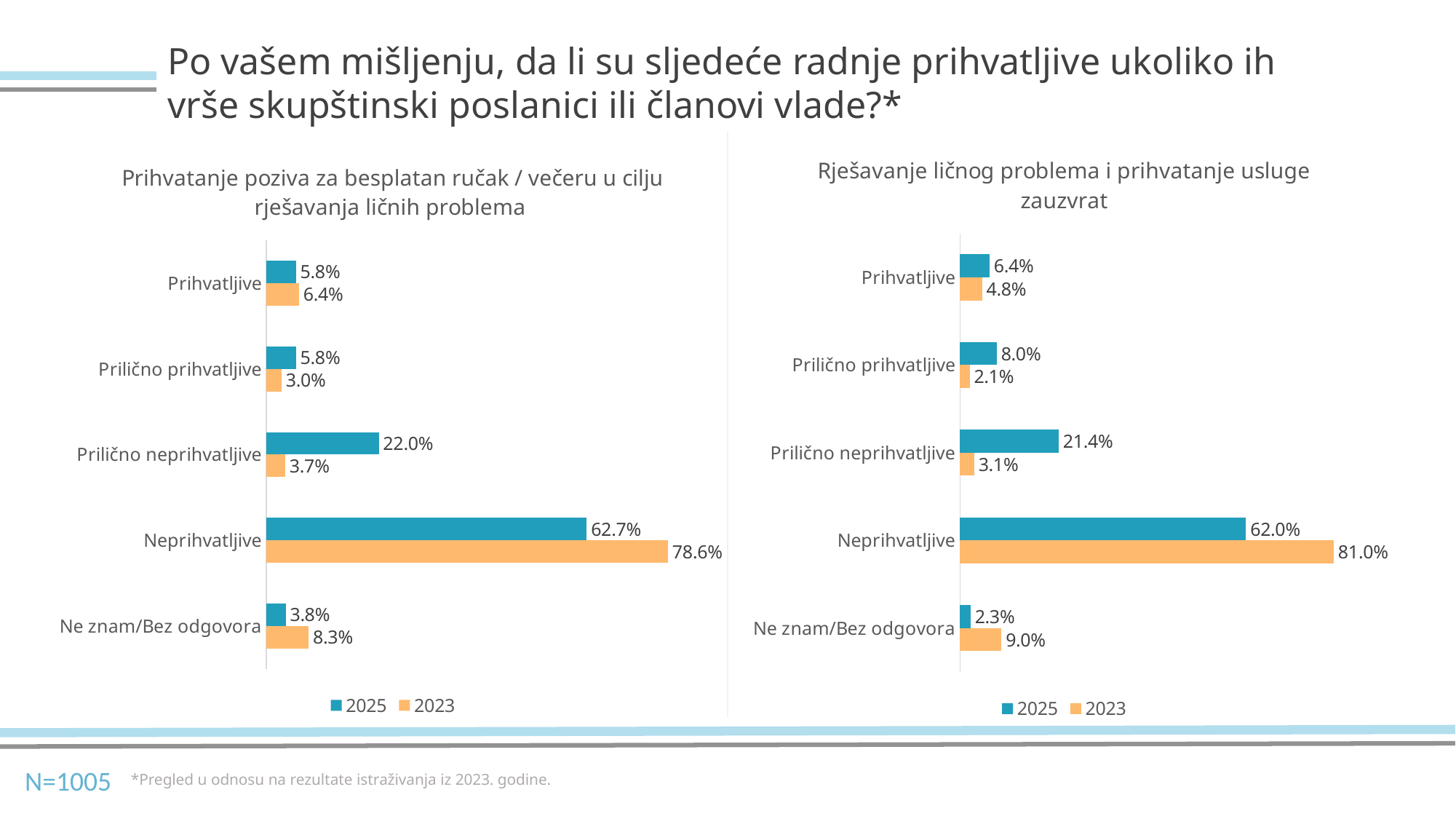
How many categories are shown in the left chart (Prihvatanje poziva za besplatan ručak / večeru)? 5 In the right chart (Rješavanje ličnog problema i prihvatanje usluge zauzvrat), what is the difference between the 2025 and 2023 values for Prilično neprihvatljive? 18.3% In the left chart (Prihvatanje poziva za besplatan ručak / večeru), what is the difference between the 2023 and 2025 values for Neprihvatljive? 15.9% In the left chart (Prihvatanje poziva za besplatan ručak / večeru), which category has the highest 2025 value? Neprihvatljive How many series does the legend of the right chart (Rješavanje ličnog problema i prihvatanje usluge zauzvrat) list? 2 In the right chart (Rješavanje ličnog problema i prihvatanje usluge zauzvrat), which category has the lowest 2023 value? Prilično prihvatljive What type of chart is the left chart (Prihvatanje poziva za besplatan ručak / večeru)? Bar chart In the right chart (Rješavanje ličnog problema i prihvatanje usluge zauzvrat), what is the 2023 value for Ne znam/Bez odgovora? 9.0% In the left chart (Prihvatanje poziva za besplatan ručak / večeru), what is the 2025 value for Prilično neprihvatljive? 22.0% In the right chart (Rješavanje ličnog problema i prihvatanje usluge zauzvrat), what is the 2025 value for Prilično prihvatljive? 8.0% In the left chart (Prihvatanje poziva za besplatan ručak / večeru), what is the 2023 value for Neprihvatljive? 78.6% In the right chart (Rješavanje ličnog problema i prihvatanje usluge zauzvrat), which is larger for Prihvatljive: the 2025 value or the 2023 value? 2025